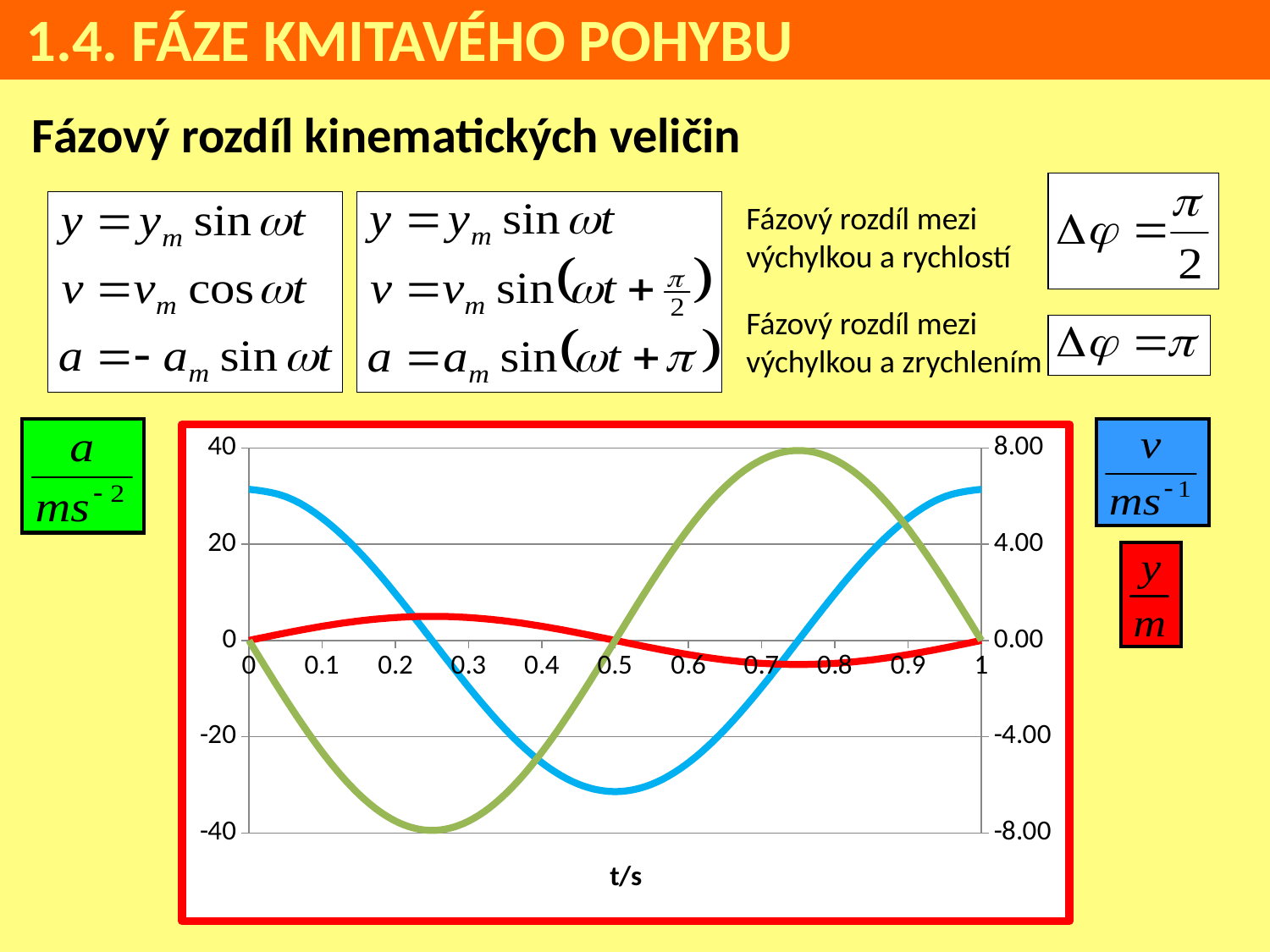
What is the value of the red curve at t = 0.5? 0 Is the value of the green curve at t = 0.25 greater or less than -20 on the left axis? less What is the label of the horizontal axis of the chart? t/s What is the value of the green curve at t = 0 on the left axis? 0 What is the highest value shown on the right vertical axis? 8.00 What is the lowest value shown on the right vertical axis? -8.00 Does the blue curve rise or fall between t = 0 and t = 0.5? fall What is the highest value shown on the left vertical axis? 40 What colour is the curve representing the acceleration a? green How many curves are plotted on the chart? 3 What kind of chart is shown on the slide? line chart Is the value of the blue curve at t = 0 greater or less than 4.00 on the right axis? greater